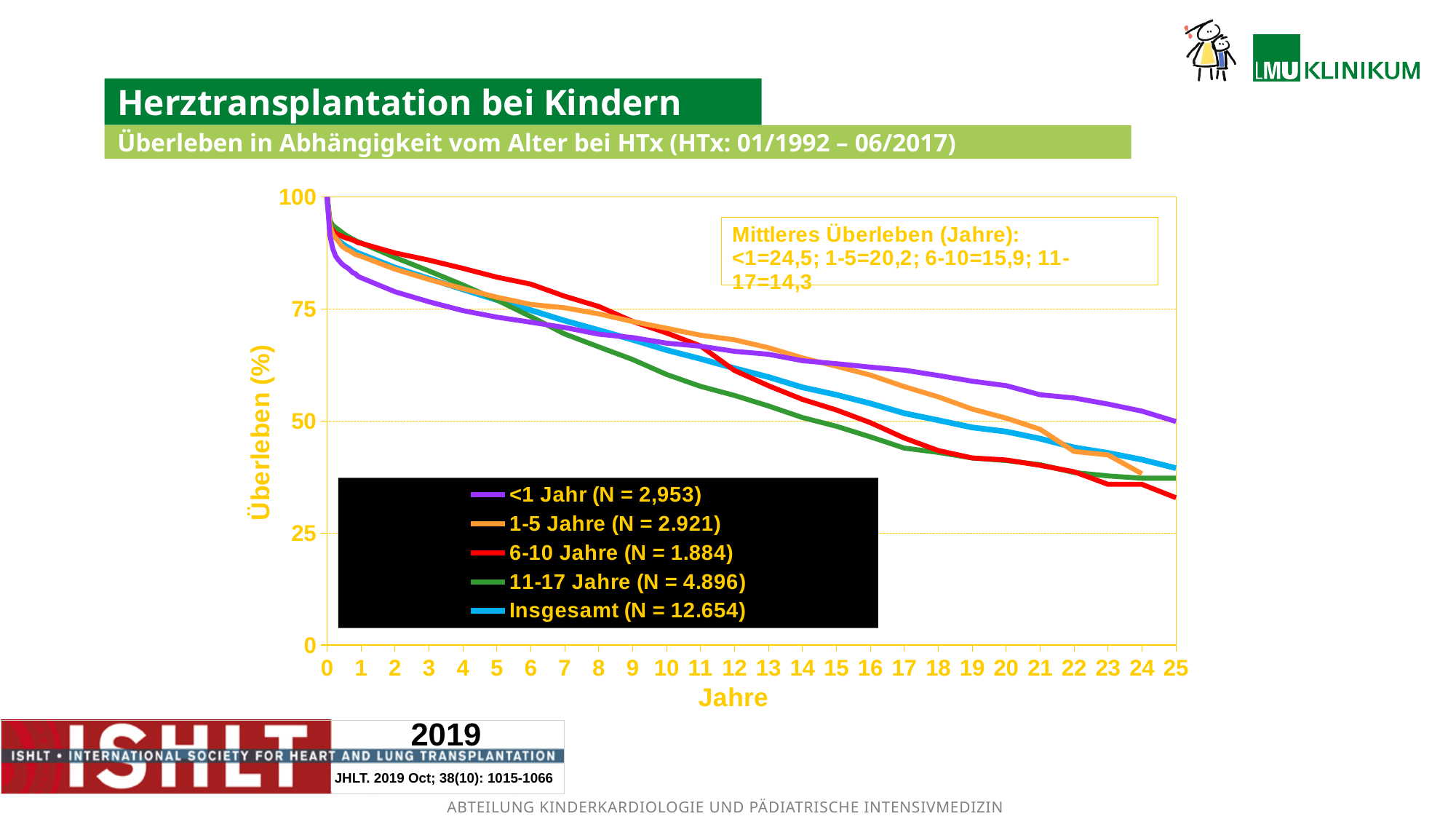
At 20 years, which is larger: the survival for <1 Jahr or for 6-10 Jahre? <1 Jahr Is the survival value for 6-10 Jahre at 25 years greater or less than 50? less Which age group has the lowest survival at 25 years? 6-10 Jahre According to the text box, what is the mean survival in years (Mittleres Überleben) for the <1 group? 24,5 How many series does the legend list? 5 Which age group has the highest survival at 25 years? <1 Jahr What kind of chart is shown on the slide? line chart What is the N given in the legend for the Insgesamt series? 12.654 Is the survival value for 6-10 Jahre at 5 years greater or less than 75? greater What is the label of the y axis? Überleben (%) Do the survival curves rise or fall as the years on the x axis increase? fall Is the survival value for 11-17 Jahre at 10 years greater or less than 50? greater